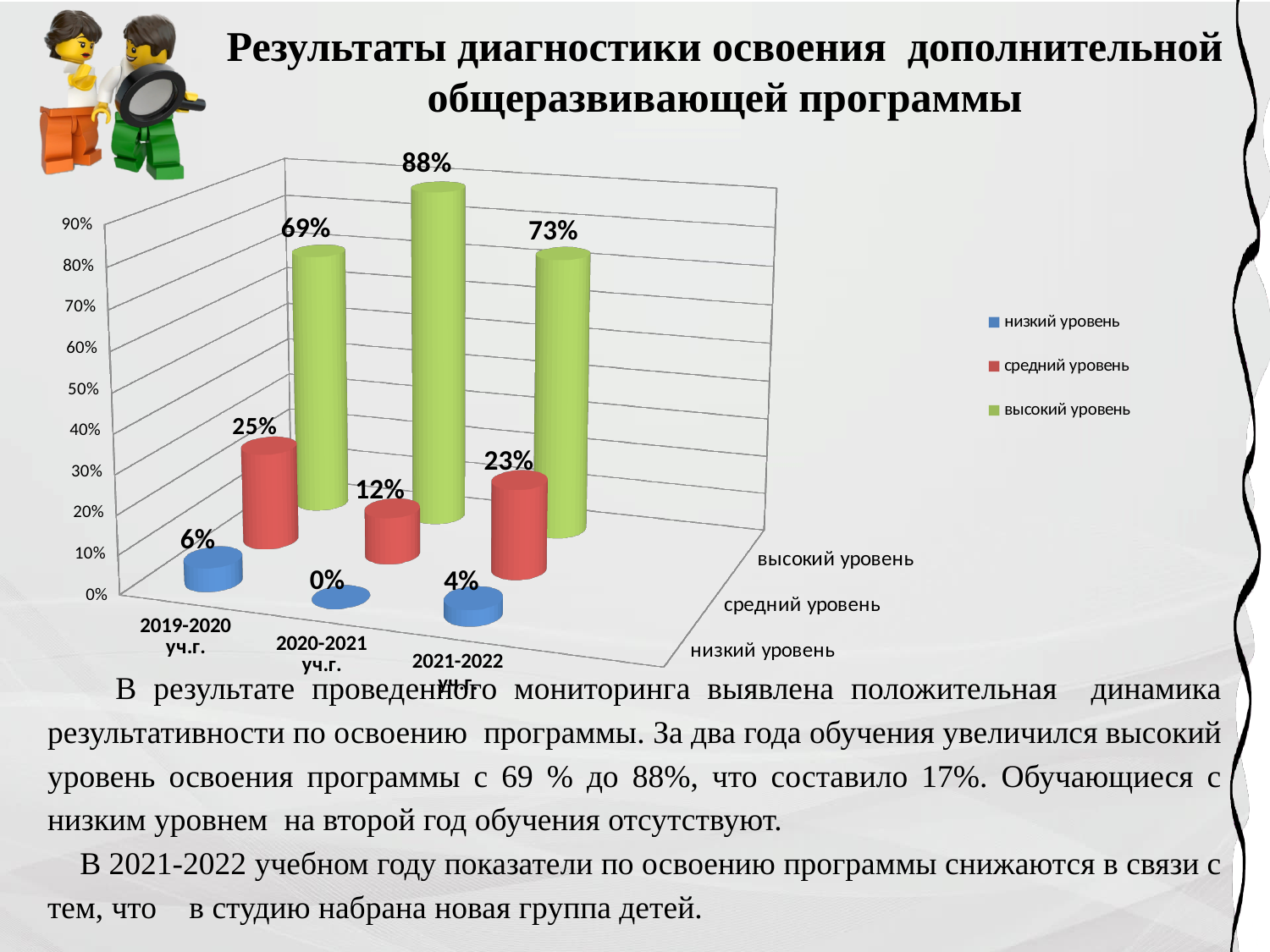
How many series does the legend list? 3 Which colour represents высокий уровень in the legend? green What is the value for низкий уровень in 2020-2021 уч.г.? 0% What is the difference between the высокий уровень values for 2020-2021 уч.г. and 2019-2020 уч.г.? 19% What is the value for средний уровень in 2019-2020 уч.г.? 25% What is the value for высокий уровень in 2020-2021 уч.г.? 88% How many years (categories) are shown on the x axis? 3 In which year is the value for высокий уровень the highest? 2020-2021 уч.г. In which year is the value for средний уровень the lowest? 2020-2021 уч.г. Which is larger: средний уровень in 2021-2022 уч.г. or средний уровень in 2020-2021 уч.г.? 2021-2022 уч.г. What is the value for низкий уровень in 2021-2022 уч.г.? 4% What kind of chart is shown on the slide? bar chart